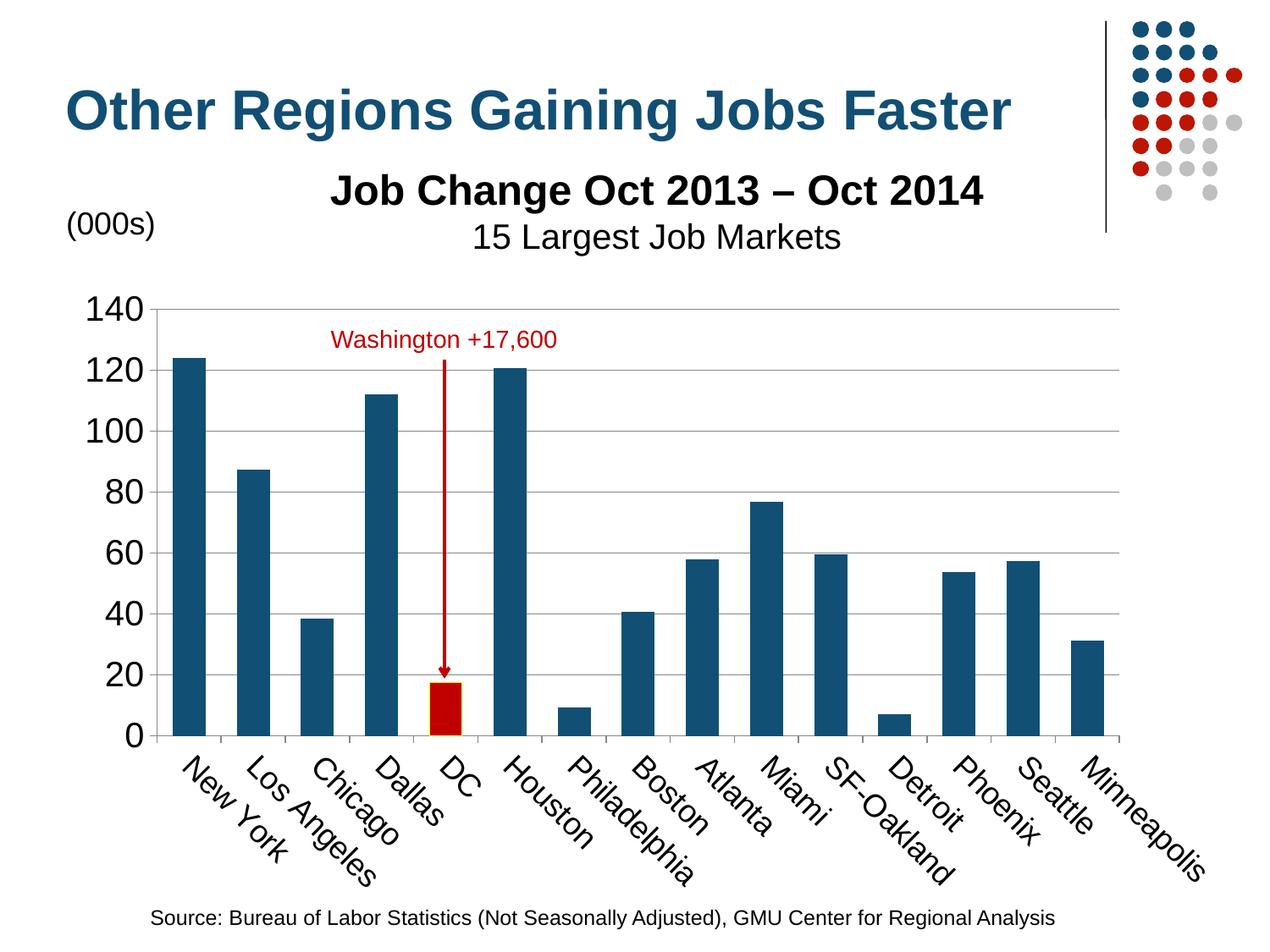
What kind of chart is shown on the slide? bar chart Is the value for Detroit greater or less than 20? less Is the value for New York greater or less than 120? greater Is the value for Los Angeles greater or less than 80? greater Which job market's bar is highlighted in red on the chart? DC Which has a larger job change, Dallas or Chicago? Dallas How many job markets are shown on the chart? 15 Which has a larger job change, Miami or Phoenix? Miami What job change value is annotated for Washington (DC) on the chart? +17,600